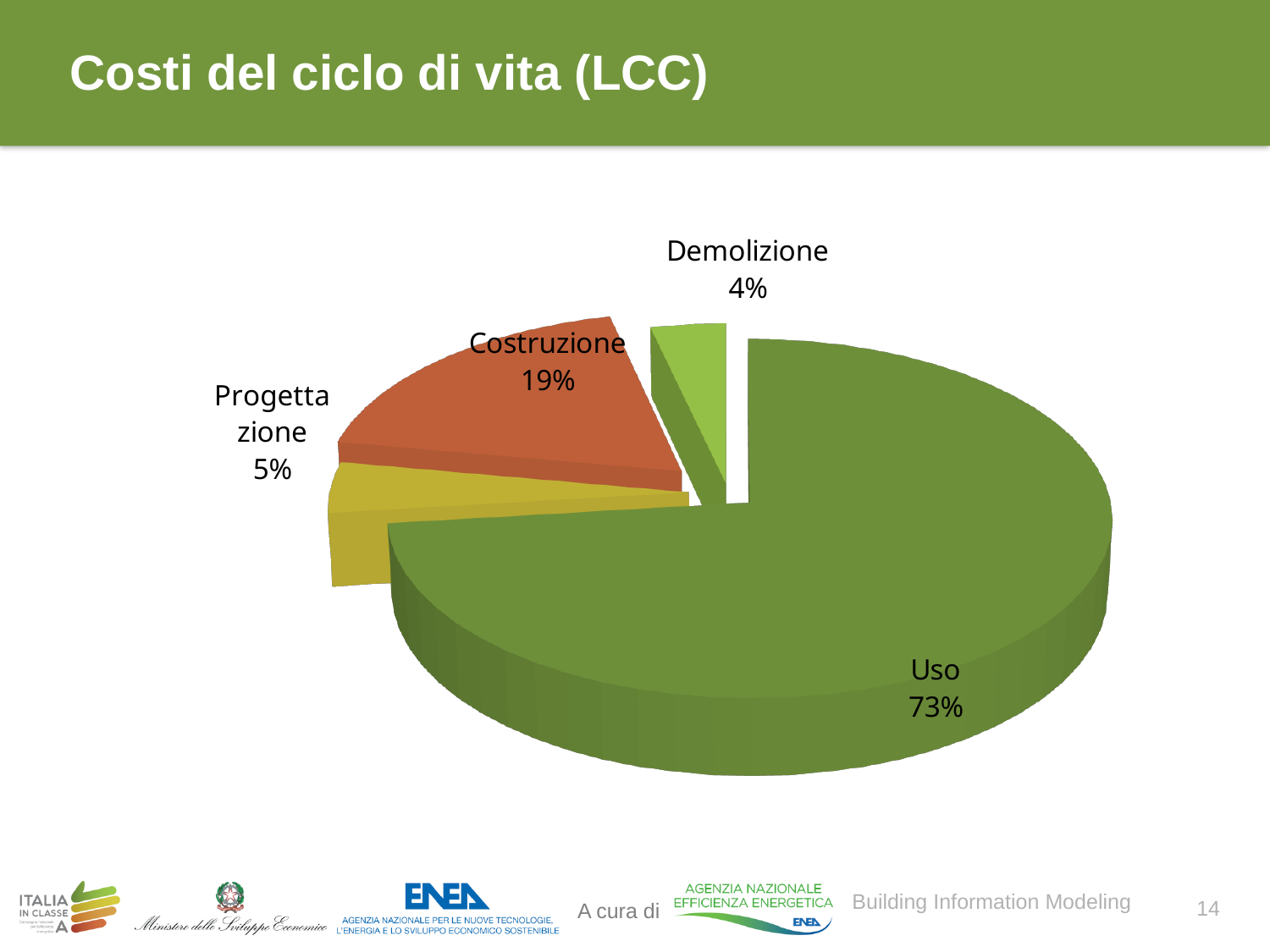
What share of the pie does Uso represent? 73% What is the value shown for Costruzione? 19% Which category has the smallest slice of the pie? Demolizione What is the title of the slide containing the chart? Costi del ciclo di vita (LCC) Which category has the largest slice of the pie? Uso What is the difference between the Progettazione and Demolizione shares? 1% Which is larger, the share for Costruzione or the share for Progettazione? Costruzione What is the value shown for Progettazione? 5% How many categories are shown in the pie chart? 4 What kind of chart is shown on the slide? Pie chart What is the difference between the Uso and Costruzione shares? 54% What is the value shown for Demolizione? 4%